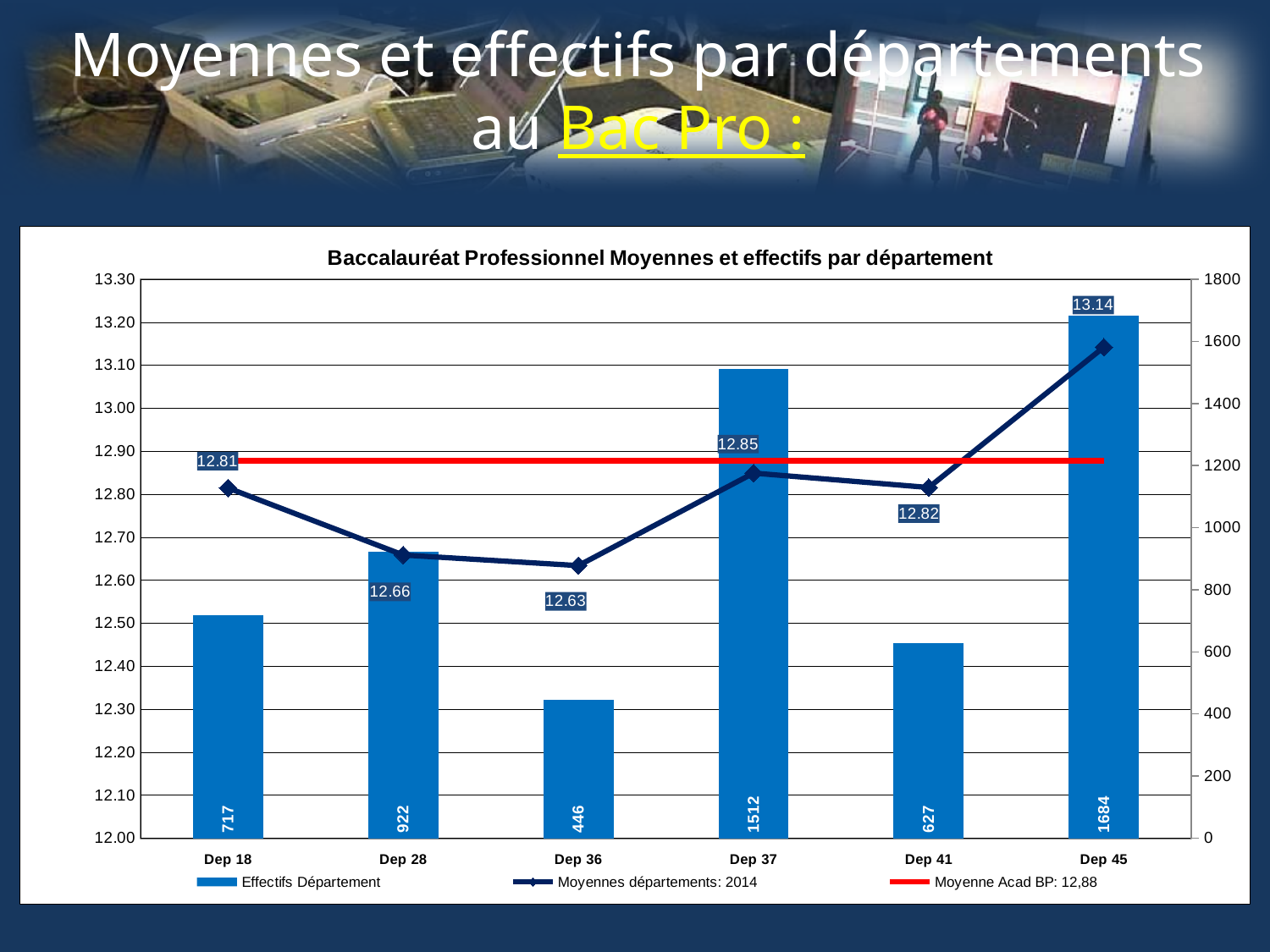
Is the Effectifs Département value for Dep 36 greater or less than 600? less What is the Effectifs Département value for Dep 37? 1512 Which department has the highest Effectifs Département? Dep 45 What is the difference between the Moyennes départements: 2014 values for Dep 45 and Dep 28? 0.48 Which has a larger Effectifs Département, Dep 28 or Dep 41? Dep 28 What is the difference in Effectifs Département between Dep 45 and Dep 18? 967 Which department has the lowest Moyennes départements: 2014 value? Dep 36 How many series does the legend list? 3 What is the Moyenne Acad BP value given in the legend? 12,88 What is the Moyennes départements: 2014 value for Dep 36? 12.63 How many departments are shown on the x axis? 6 What is the title of the chart? Baccalauréat Professionnel Moyennes et effectifs par département